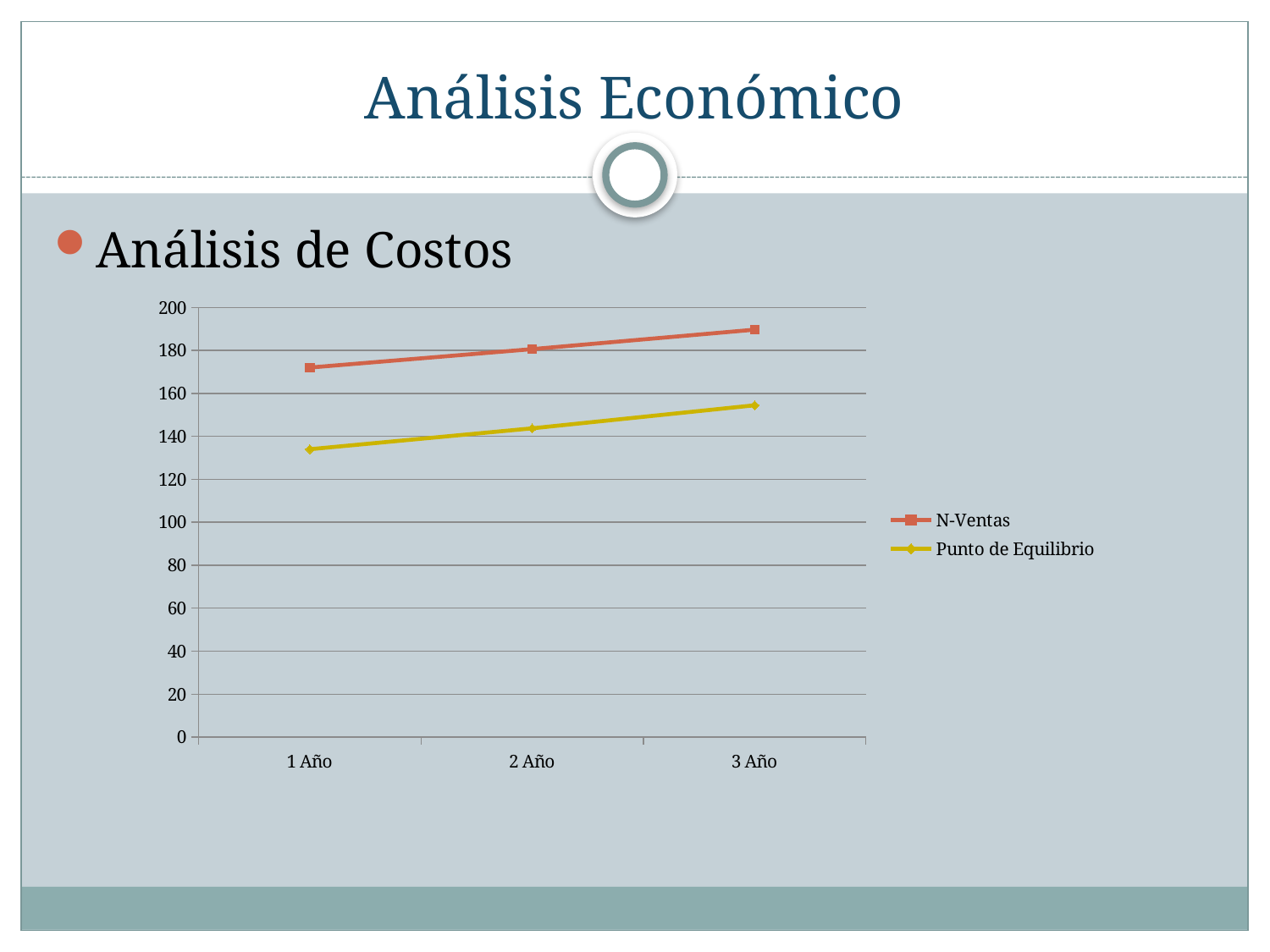
How many categories are shown on the x axis? 3 Which series is shown in red? N-Ventas At 2 Año, which is larger: N-Ventas or Punto de Equilibrio? N-Ventas In which year is Punto de Equilibrio lowest? 1 Año In which year is N-Ventas highest? 3 Año Do the N-Ventas values rise or fall from 1 Año to 3 Año? Rise How many series does the legend list? 2 What kind of chart is shown on the slide? Line chart Is the value for N-Ventas at 1 Año greater or less than 160? greater Do the Punto de Equilibrio values rise or fall from 1 Año to 3 Año? Rise What are the two series named in the legend? N-Ventas and Punto de Equilibrio Is the value for Punto de Equilibrio at 3 Año greater or less than 160? less